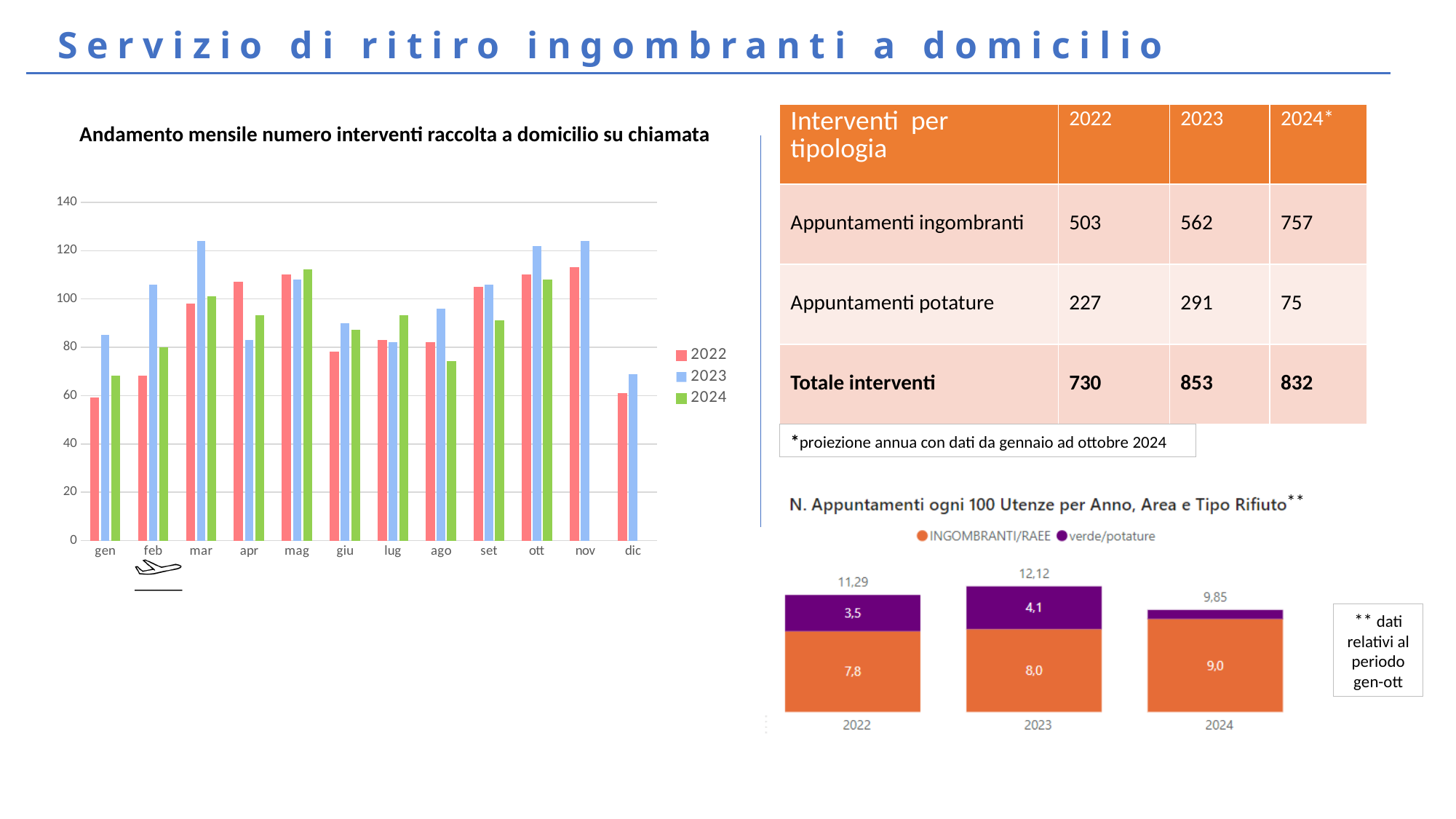
In the right chart 'N. Appuntamenti ogni 100 Utenze per Anno, Area e Tipo Rifiuto', which year has the highest total? 2023 In the left chart 'Andamento mensile numero interventi raccolta a domicilio su chiamata', which month has the lowest 2023 value? dic In the right chart 'N. Appuntamenti ogni 100 Utenze per Anno, Area e Tipo Rifiuto', what is the INGOMBRANTI/RAEE value for 2024? 9,0 In the left chart 'Andamento mensile numero interventi raccolta a domicilio su chiamata', how many series does the legend list? 3 What kind of chart is the left chart titled 'Andamento mensile numero interventi raccolta a domicilio su chiamata'? bar chart In the left chart 'Andamento mensile numero interventi raccolta a domicilio su chiamata', is the 2023 value for dic greater or less than 80? less In the right chart 'N. Appuntamenti ogni 100 Utenze per Anno, Area e Tipo Rifiuto', what is the verde/potature value for 2023? 4,1 In the left chart 'Andamento mensile numero interventi raccolta a domicilio su chiamata', which is larger for gen: the 2022 value or the 2023 value? 2023 In the left chart 'Andamento mensile numero interventi raccolta a domicilio su chiamata', how many months are shown on the x axis? 12 In the right chart 'N. Appuntamenti ogni 100 Utenze per Anno, Area e Tipo Rifiuto', what is the difference between the verde/potature values for 2023 and 2022? 0,6 In the left chart 'Andamento mensile numero interventi raccolta a domicilio su chiamata', is the 2022 value for gen greater or less than 80? less In the left chart 'Andamento mensile numero interventi raccolta a domicilio su chiamata', is the 2023 value for feb greater or less than 100? greater